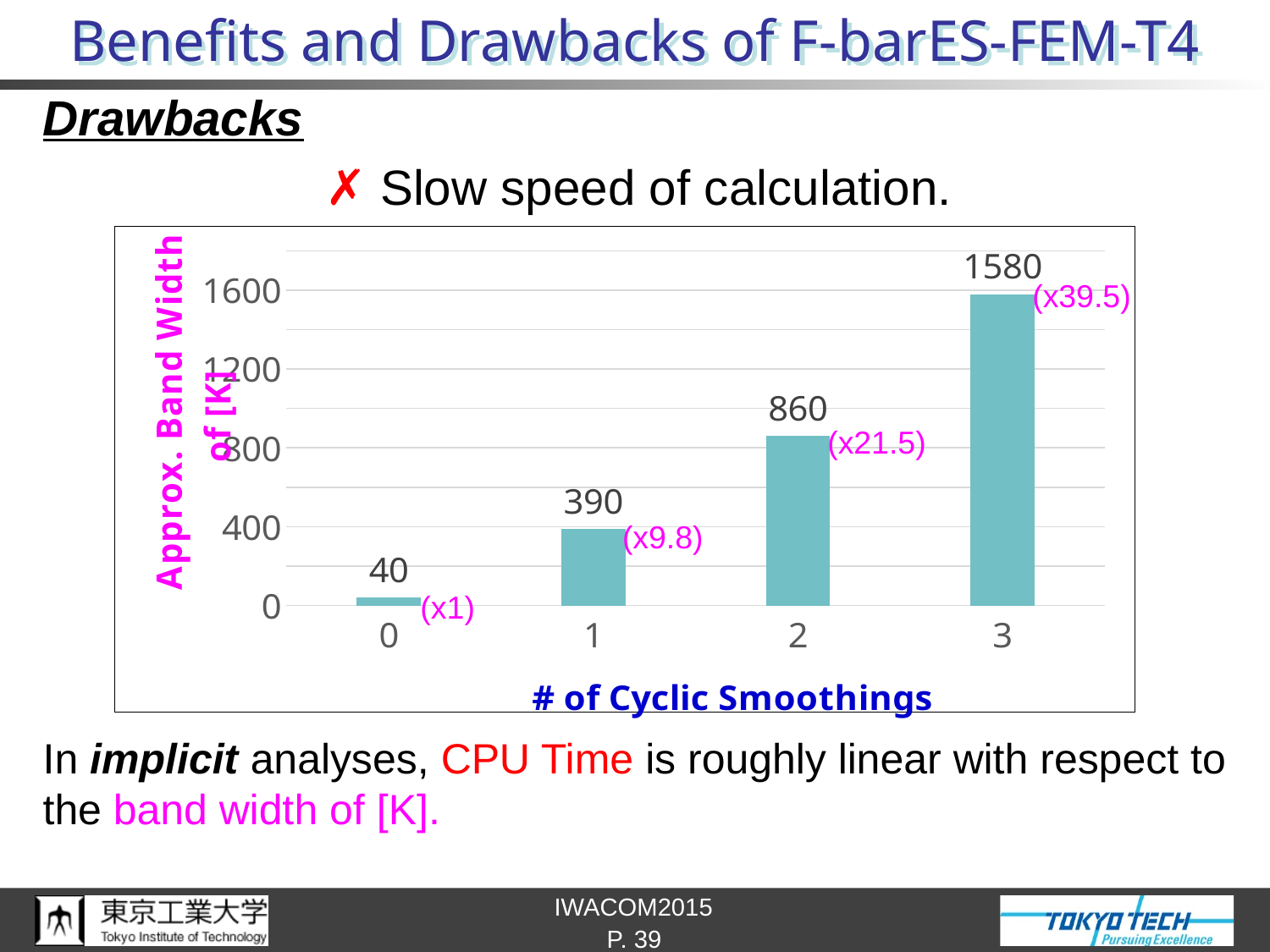
What is the approximate band width of [K] for 2 cyclic smoothings? 860 How many bars are shown in the chart? 4 What is the approximate band width of [K] for 3 cyclic smoothings? 1580 Is the band width for 2 cyclic smoothings greater or less than 800? greater What is the difference in band width between 1 and 0 cyclic smoothings? 350 What kind of chart is shown on the slide? Bar chart Which number of cyclic smoothings has the highest band width? 3 Which has a larger band width: 1 cyclic smoothing or 2 cyclic smoothings? 2 cyclic smoothings Which number of cyclic smoothings has the lowest band width? 0 Do the band width values rise or fall as the number of cyclic smoothings increases? Rise What is the difference in band width between 3 and 2 cyclic smoothings? 720 What is the approximate band width of [K] for 0 cyclic smoothings? 40